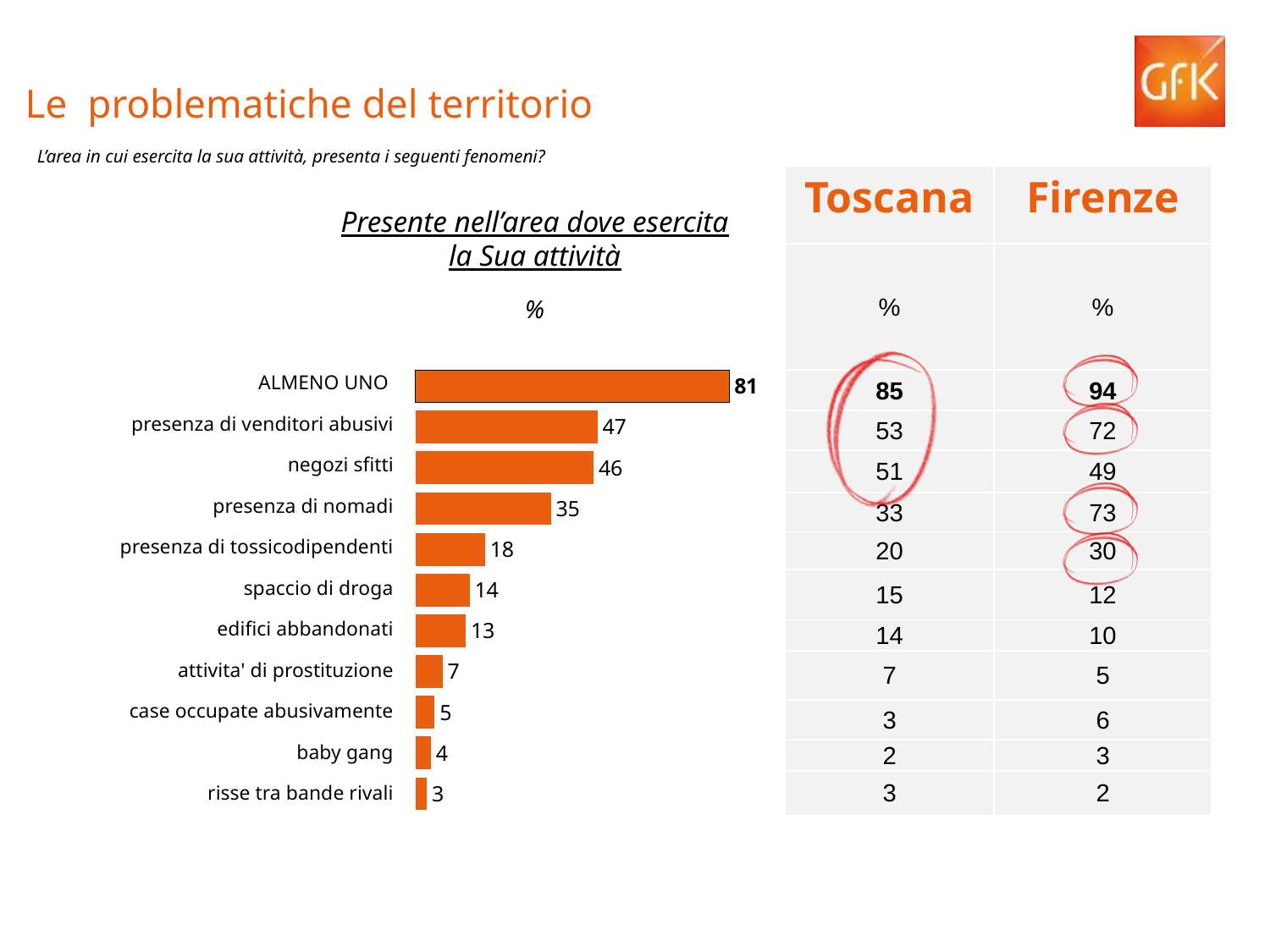
What type of chart is shown on the slide? bar chart How many categories are shown in the bar chart? 11 What is the difference between the values for 'presenza di tossicodipendenti' and 'edifici abbandonati' in the bar chart? 5 Which category has the lowest value in the bar chart? risse tra bande rivali What is the value for 'presenza di venditori abusivi' in the bar chart? 47 What is the difference between the values for 'ALMENO UNO' and 'presenza di venditori abusivi' in the bar chart? 34 What is the value for 'spaccio di droga' in the bar chart? 14 Which has a larger value in the bar chart, 'negozi sfitti' or 'presenza di nomadi'? negozi sfitti Which category has the highest value in the bar chart? ALMENO UNO What is the title of the bar chart? Presente nell'area dove esercita la Sua attività What is the value for 'risse tra bande rivali' in the bar chart? 3 What is the value for 'presenza di nomadi' in the bar chart? 35